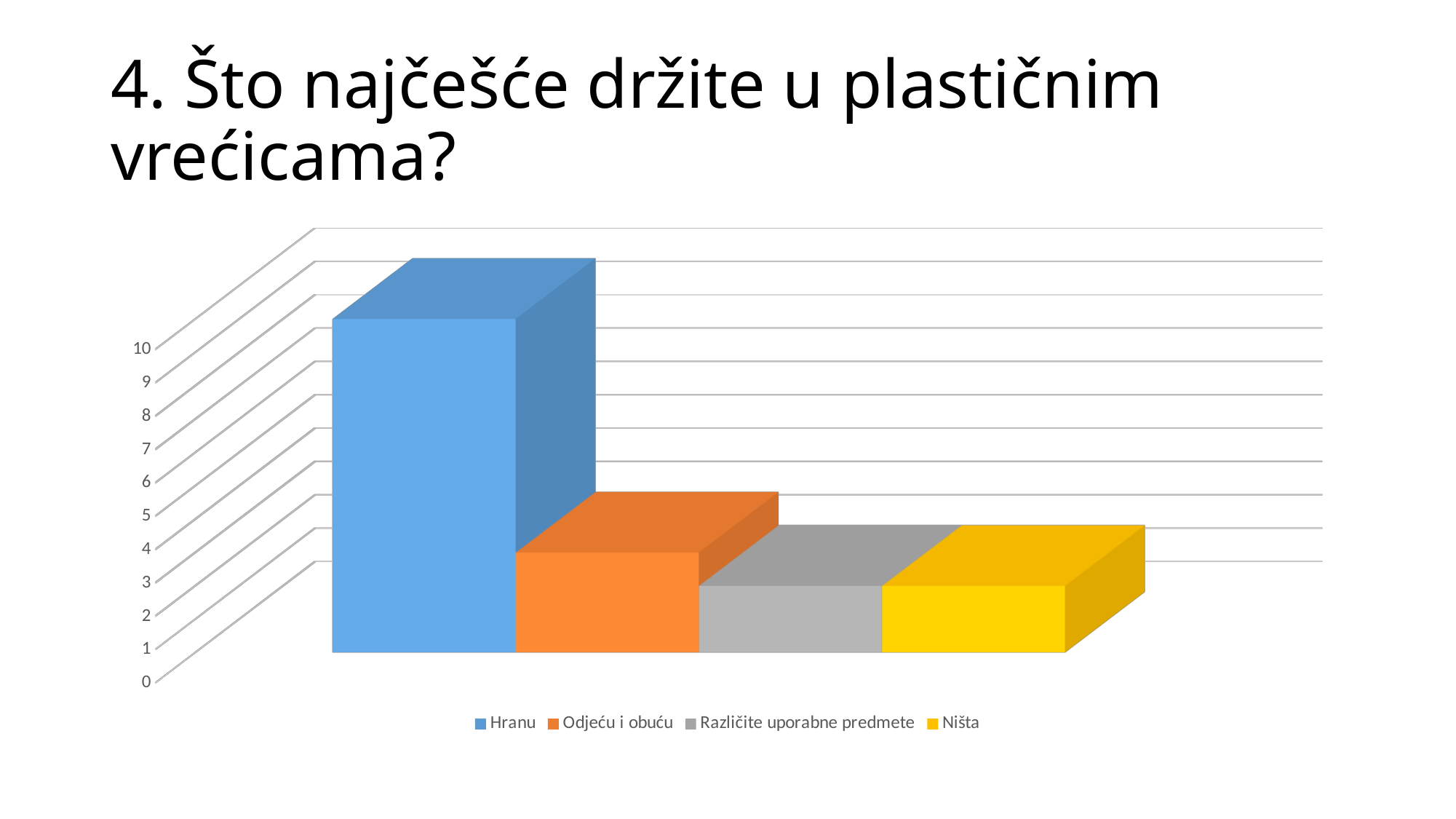
Which is larger, the value for Odjeću i obuću or the value for Ništa? Odjeću i obuću Is the value for Različite uporabne predmete greater or less than 6? less Is the value for Hranu greater or less than 8? greater How many entries does the legend list? 4 What is the title of the slide containing the chart? 4. Što najčešće držite u plastičnim vrećicama? Which is larger, the value for Hranu or the value for Odjeću i obuću? Hranu Is the value for Odjeću i obuću greater or less than 5? less What kind of chart is shown on the slide? bar chart How many bars does the chart show? 4 Which category has the highest value? Hranu Which legend entry is shown in yellow? Ništa